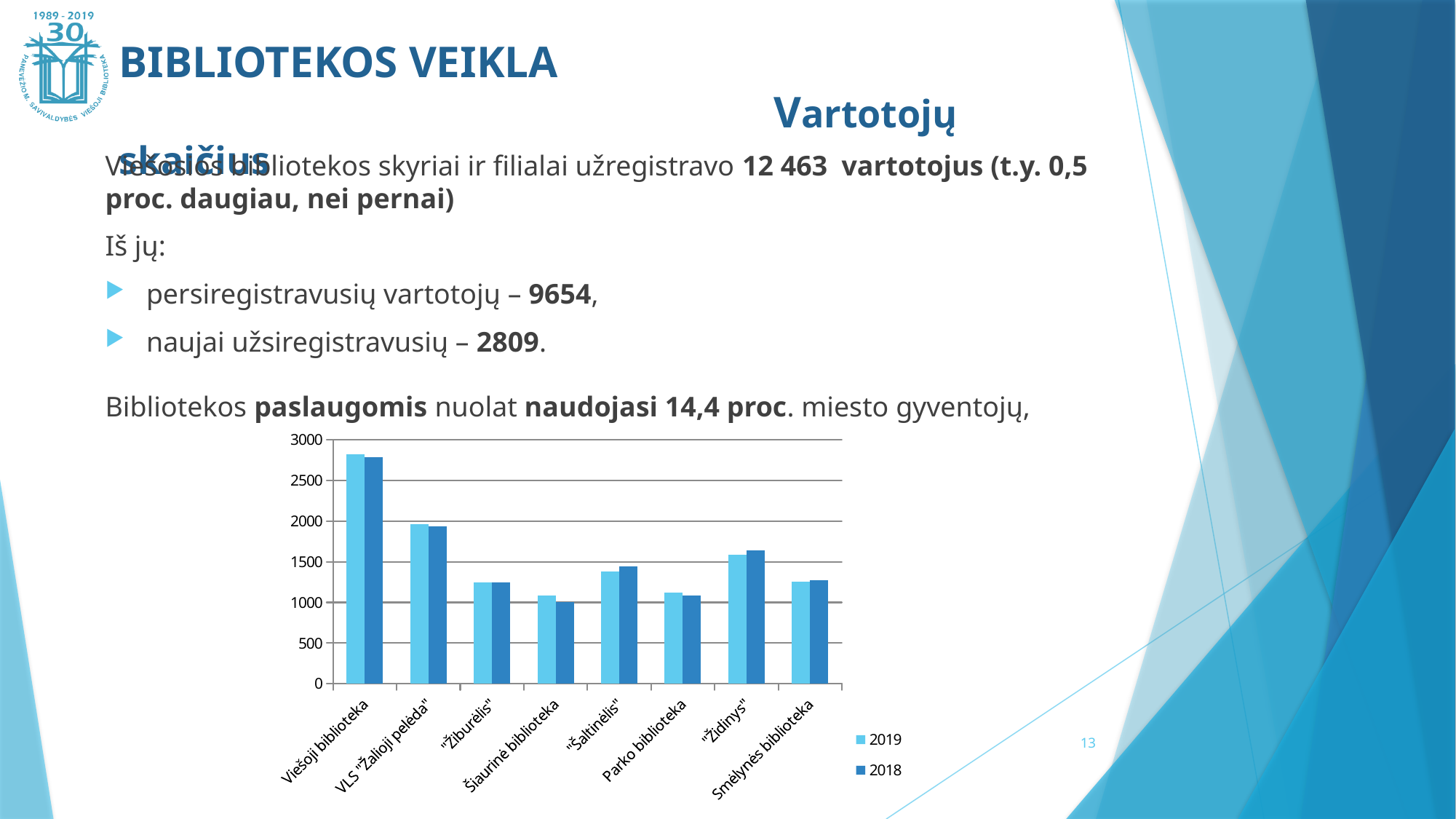
How many series does the chart legend list? 2 How many library categories are shown on the x axis of the chart? 8 Is the 2019 value for Viešoji biblioteka greater or less than 2500? greater Which series is shown in the lighter blue colour in the chart? 2019 For "Židinys", which year has the larger value, 2019 or 2018? 2018 Is the 2018 value for "Židinys" greater or less than 1500? greater Which library has the highest value in the chart? Viešoji biblioteka Which has the larger 2019 value, Viešoji biblioteka or VLS "Žalioji pelėda"? Viešoji biblioteka Is the 2019 value for "Šaltinėlis" greater or less than 1500? less What kind of chart is shown on the slide? bar chart